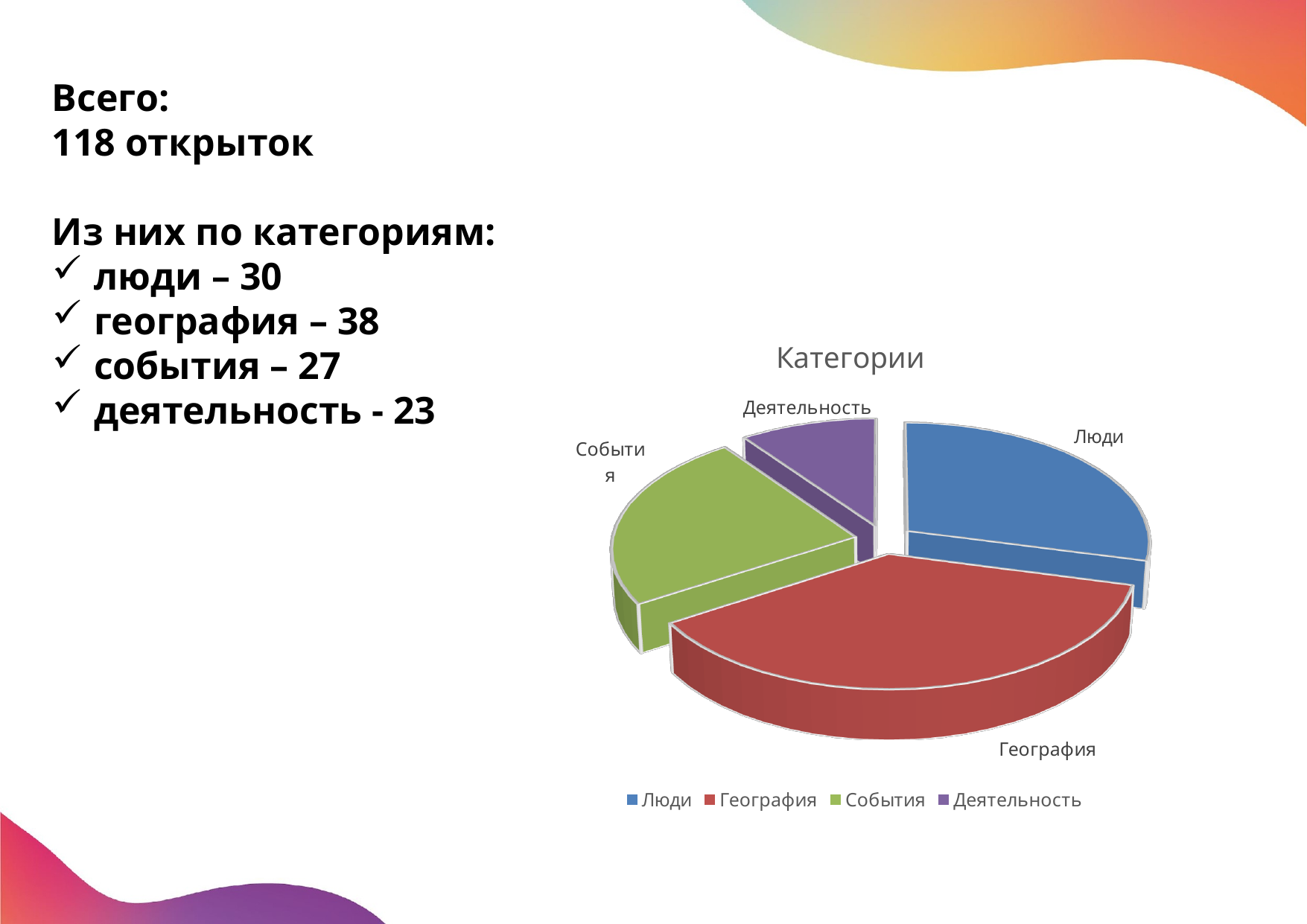
How many slices does the pie chart have? 4 Which category has the smallest slice of the pie? Деятельность Which category has the largest slice of the pie? География What is the difference between the География and Люди values? 8 What colour is the География slice in the pie chart? red How many postcards are in the География category? 38 What is the title of the chart? Категории How many postcards are in the Люди category? 30 How many entries does the chart legend list? 4 Which is larger, the Люди slice or the События slice? Люди What kind of chart is shown on the slide? pie chart How many postcards are in the Деятельность category? 23